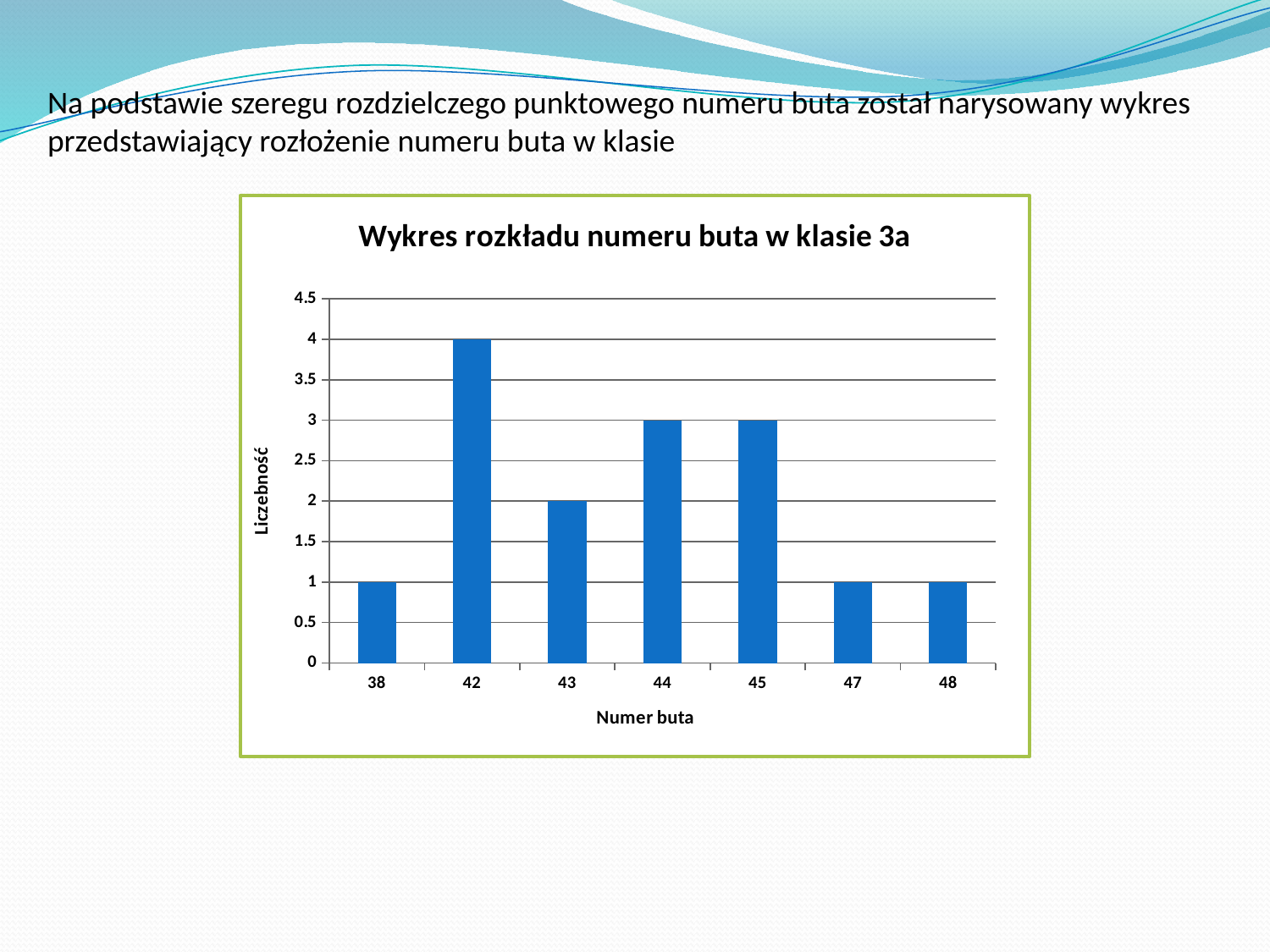
What kind of chart is shown on the slide? bar chart Is the value for shoe size 42 greater or less than 3? greater What is the value for shoe size 42? 4 What is the value for shoe size 38? 1 What is the label of the y axis? Liczebność How many shoe size categories are shown on the x axis? 7 What is the value for shoe size 43? 2 What is the difference between the values for shoe sizes 42 and 43? 2 What is the value for shoe size 44? 3 What is the title of the chart? Wykres rozkładu numeru buta w klasie 3a Which shoe size has the highest count? 42 Which has a larger value, shoe size 44 or shoe size 43? 44